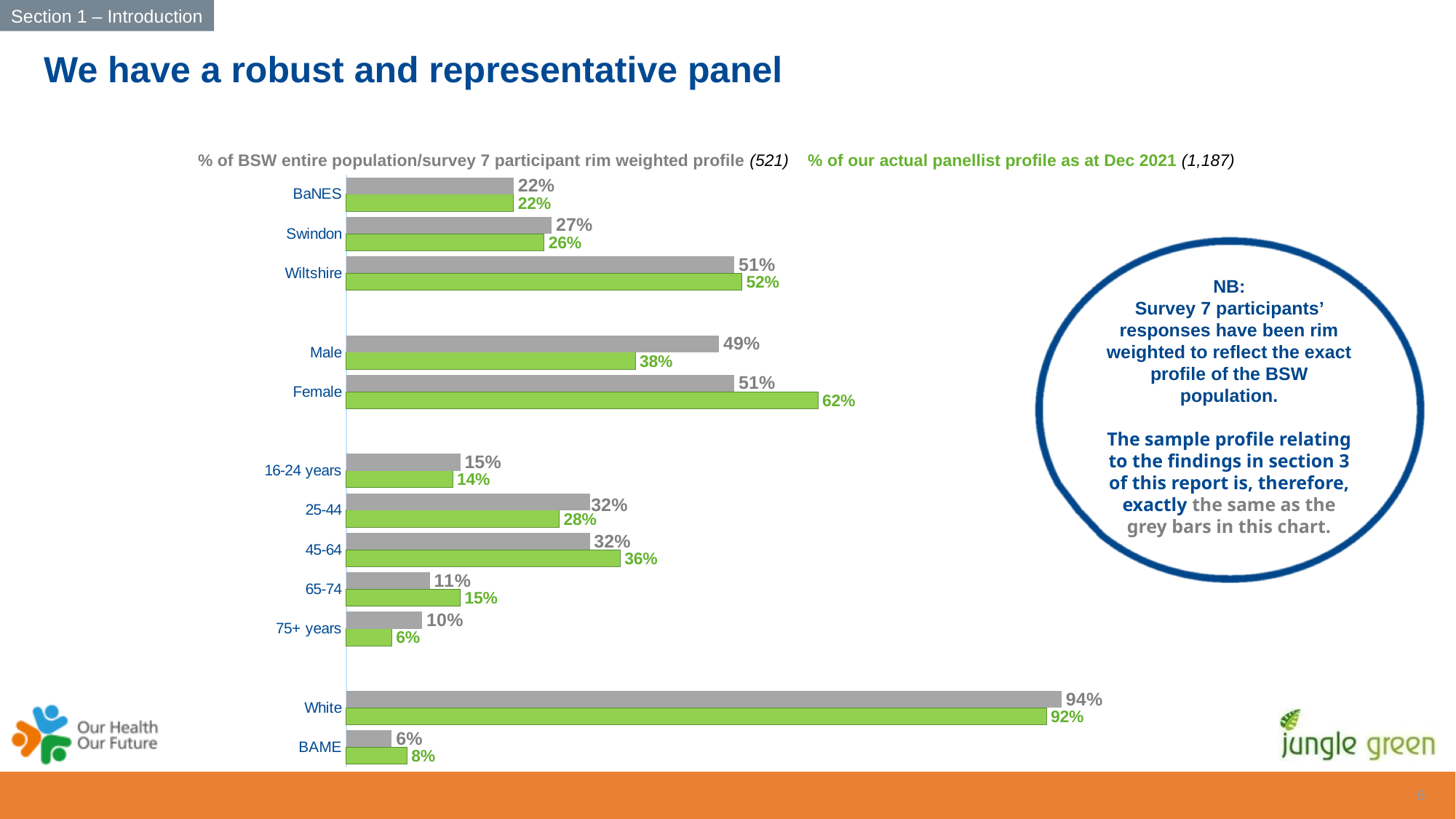
What sample size is shown in the legend for the actual panellist profile as at Dec 2021? 1,187 Which category has the lowest green (actual panellist profile) value? 75+ years How many series does the chart legend list? 2 What is the difference between the grey and green values for Male? 11% For 75+ years, which is larger: the grey BSW population value or the green panellist profile value? the grey BSW population value What is the green (actual panellist profile as at Dec 2021) value for Female? 62% What is the difference between the grey and green values for BAME? 2% Which category has the highest grey (BSW population) value? White What is the grey (BSW population / survey 7 rim weighted profile) value for Male? 49% What type of chart is shown on the slide? bar chart What is the actual panellist profile (green) value for 45-64? 36% How many categories are shown on the chart? 12